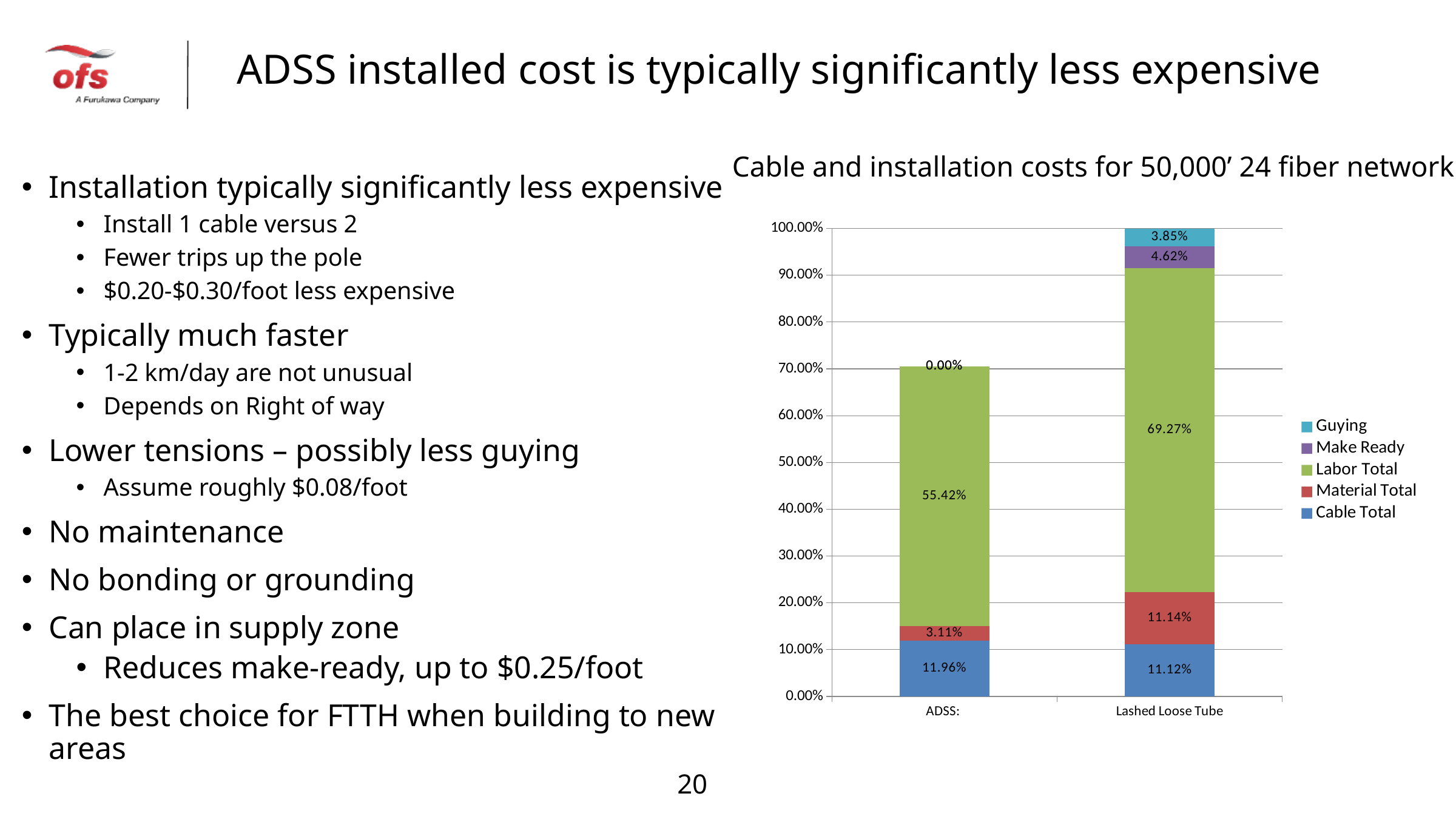
What is the Labor Total value for ADSS? 55.42% What is the title of the chart? Cable and installation costs for 50,000' 24 fiber network What is the Make Ready value for ADSS? 0.00% How many categories are shown on the x axis of the chart? 2 What is the Material Total value for Lashed Loose Tube? 11.14% What is the Guying value for Lashed Loose Tube? 3.85% Which category has the larger Labor Total value, ADSS or Lashed Loose Tube? Lashed Loose Tube What is the difference between the Labor Total values for Lashed Loose Tube and ADSS? 13.85% What kind of chart is shown on the slide? Stacked bar chart What is the total of the stacked bar for Lashed Loose Tube? 100.00% How many series does the chart legend list? 5 What is the difference between the Material Total values for Lashed Loose Tube and ADSS? 8.03%